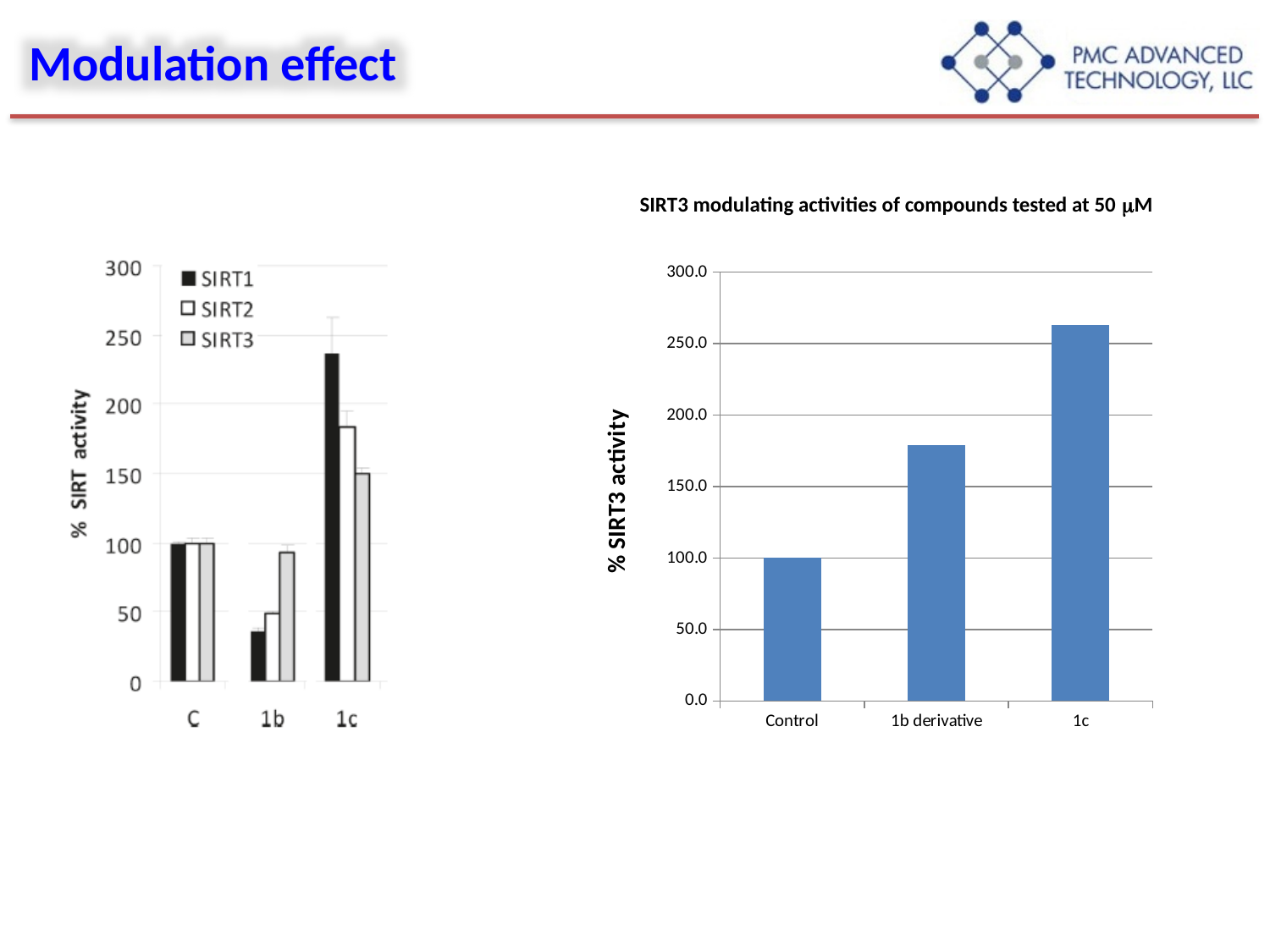
In the chart titled 'SIRT3 modulating activities of compounds tested at 50 μM', is the value for 1c greater or less than 250.0? greater What kind of chart is the one titled 'SIRT3 modulating activities of compounds tested at 50 μM'? bar chart In the chart titled 'SIRT3 modulating activities of compounds tested at 50 μM', which category has the lowest value? Control In the chart titled 'SIRT3 modulating activities of compounds tested at 50 μM', do the values rise or fall from Control to 1c along the x axis? rise In the chart on the left of the slide, how many series does the legend list? 3 In the chart on the left of the slide, which is larger for 1b: the SIRT3 value or the SIRT1 value? SIRT3 In the chart on the left of the slide, is the SIRT1 value for 1b greater or less than 50? less In the chart on the left of the slide, which series has the highest value for 1c? SIRT1 In the chart titled 'SIRT3 modulating activities of compounds tested at 50 μM', how many categories are shown on the x axis? 3 In the chart titled 'SIRT3 modulating activities of compounds tested at 50 μM', is the value for 1b derivative greater or less than 200.0? less What is the y-axis label of the chart titled 'SIRT3 modulating activities of compounds tested at 50 μM'? % SIRT3 activity In the chart titled 'SIRT3 modulating activities of compounds tested at 50 μM', which category has the highest value? 1c